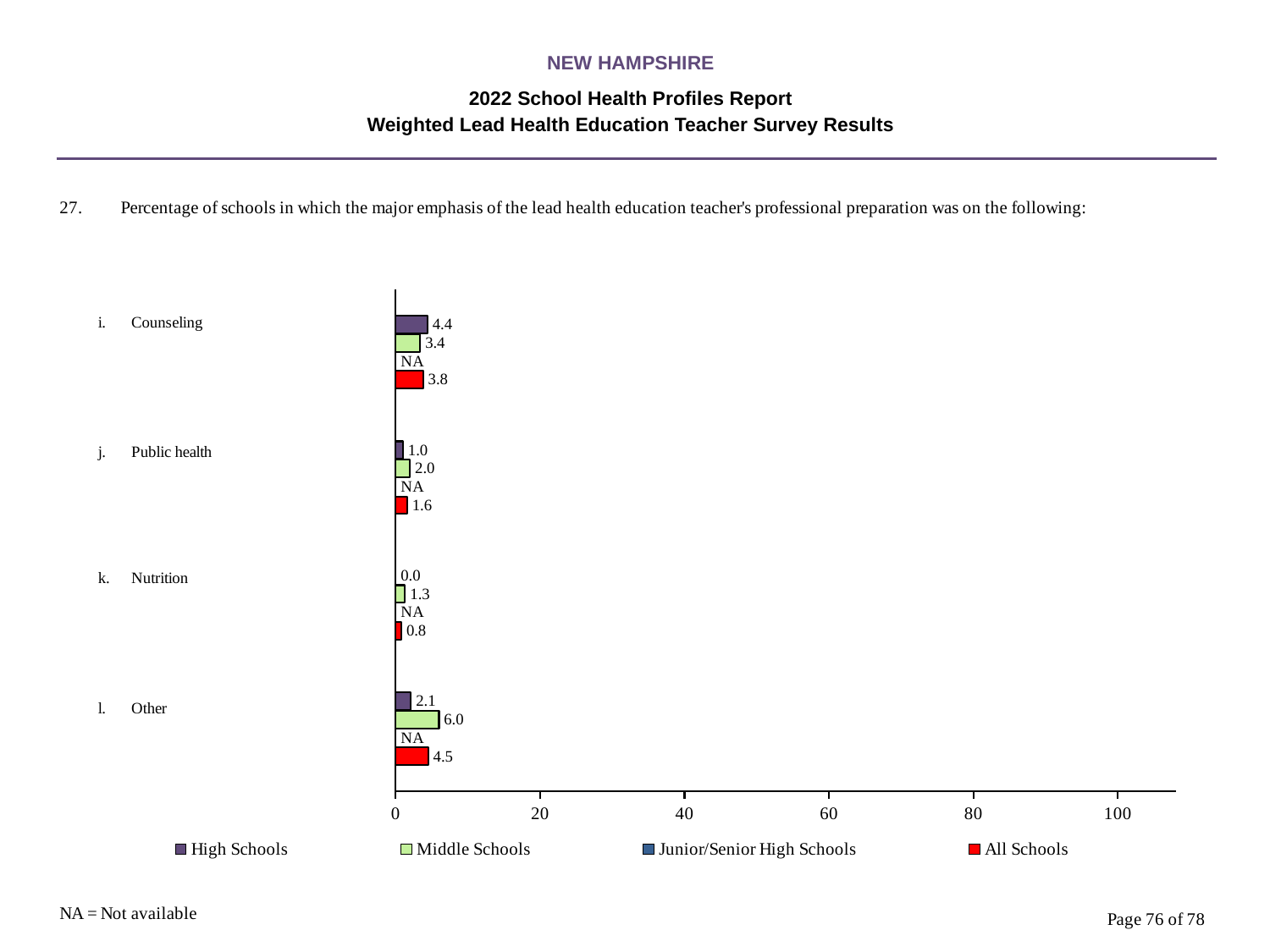
What kind of chart is this? bar chart How many categories are shown in the chart? 4 What is the value for All Schools for Public health? 1.6 How many series does the legend list? 4 What is the difference between the Middle Schools and High Schools values for Other? 3.9 What is the value for High Schools for Nutrition? 0.0 What is the value for High Schools for Counseling? 4.4 Which is larger for Counseling: High Schools or Middle Schools? High Schools What is shown for Junior/Senior High Schools for Counseling? NA Which category has the lowest All Schools value? Nutrition Which category has the highest All Schools value? Other What is the value for Middle Schools for Other? 6.0